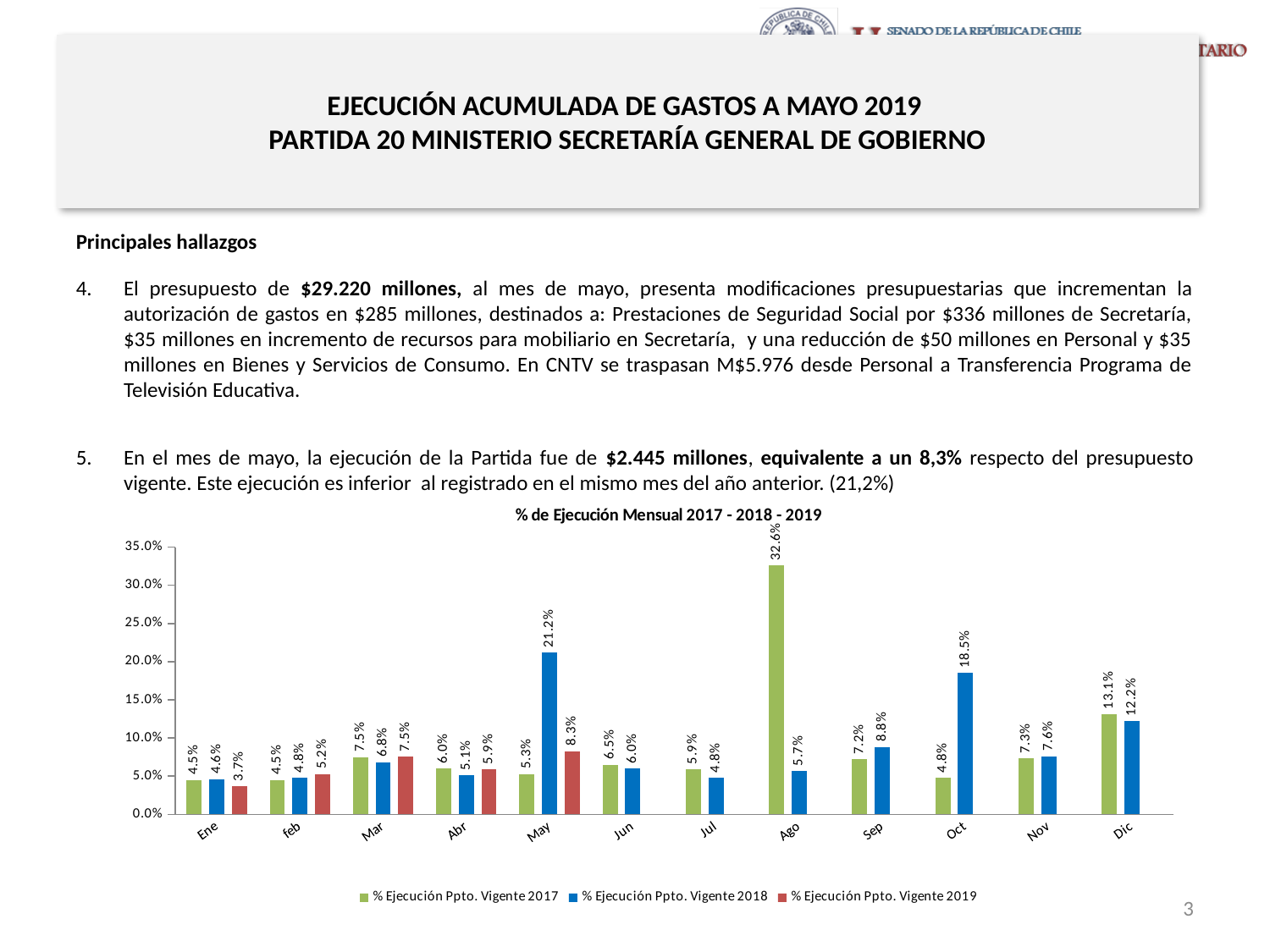
How many months are shown on the x axis? 12 What is the value for % Ejecución Ppto. Vigente 2017 in Dic? 13.1% Which is larger in Sep: the 2017 value or the 2018 value? 2018 Is the value for % Ejecución Ppto. Vigente 2017 in Ago greater or less than 30.0%? greater How many series does the legend list? 3 What is the difference between the 2018 and 2019 values in May? 12.9% In which month is the % Ejecución Ppto. Vigente 2019 series lowest? Ene What is the value for % Ejecución Ppto. Vigente 2019 in May? 8.3% What kind of chart is shown? Bar chart What is the value for % Ejecución Ppto. Vigente 2018 in Oct? 18.5% In which month is the % Ejecución Ppto. Vigente 2017 series highest? Ago What is the title of the chart? % de Ejecución Mensual 2017 - 2018 - 2019